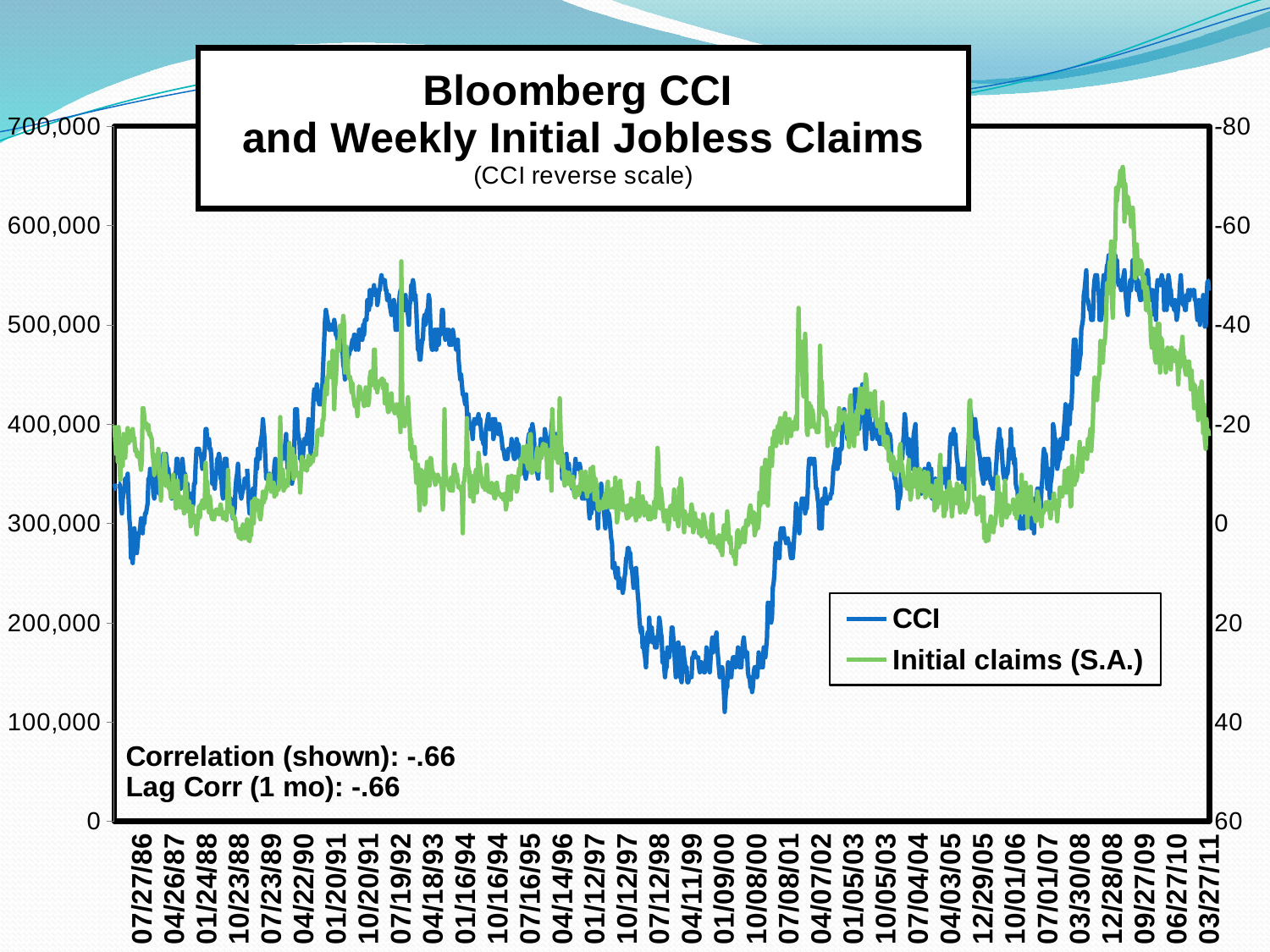
Is the value of Initial claims (S.A.) at its peak near 12/28/08 greater or less than 600,000 on the left axis? greater Is the value of Initial claims (S.A.) around 01/09/00 greater or less than 400,000 on the left axis? less Near which x-axis label does the Initial claims (S.A.) line reach its highest point? 12/28/08 Does the Initial claims (S.A.) line rise or fall between 03/30/08 and 12/28/08? rise What kind of chart is shown on the slide? line chart Does the Initial claims (S.A.) line rise or fall between 09/27/09 and 03/27/11? fall Is the CCI value around 12/28/08 greater or less than -40 on the right axis? less What is the main title of the chart? Bloomberg CCI and Weekly Initial Jobless Claims How many series does the legend list? 2 What correlation value is shown on the chart? -.66 Which is higher for Initial claims (S.A.): the value near 12/28/08 or the value near 01/09/00? 12/28/08